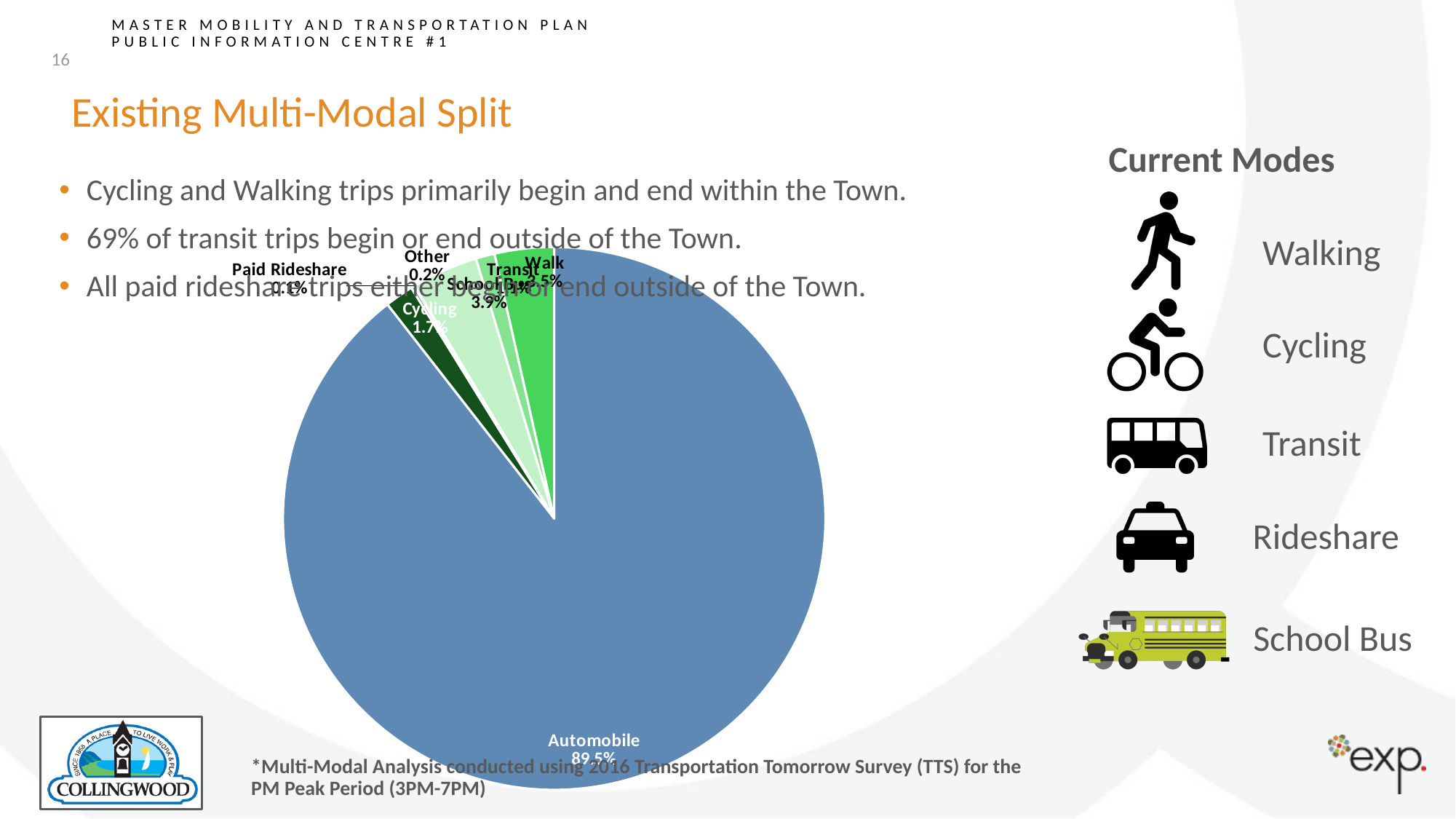
Which is larger in the pie chart, Walk or Cycling? Walk Which mode has the largest slice of the pie chart? Automobile What share of trips is Other in the pie chart? 0.2% How many slices (modes) does the pie chart show? 7 What share of trips is Walk in the pie chart? 3.5% What is the difference between the Automobile share and the Walk share in the pie chart? 86.0% What share of trips is School Bus in the pie chart? 3.9% What share of trips is Automobile in the pie chart? 89.5% What share of trips is Cycling in the pie chart? 1.7% What kind of chart is shown on the slide? pie chart Which is larger in the pie chart, School Bus or Walk? School Bus What colour is the Automobile slice in the pie chart? blue